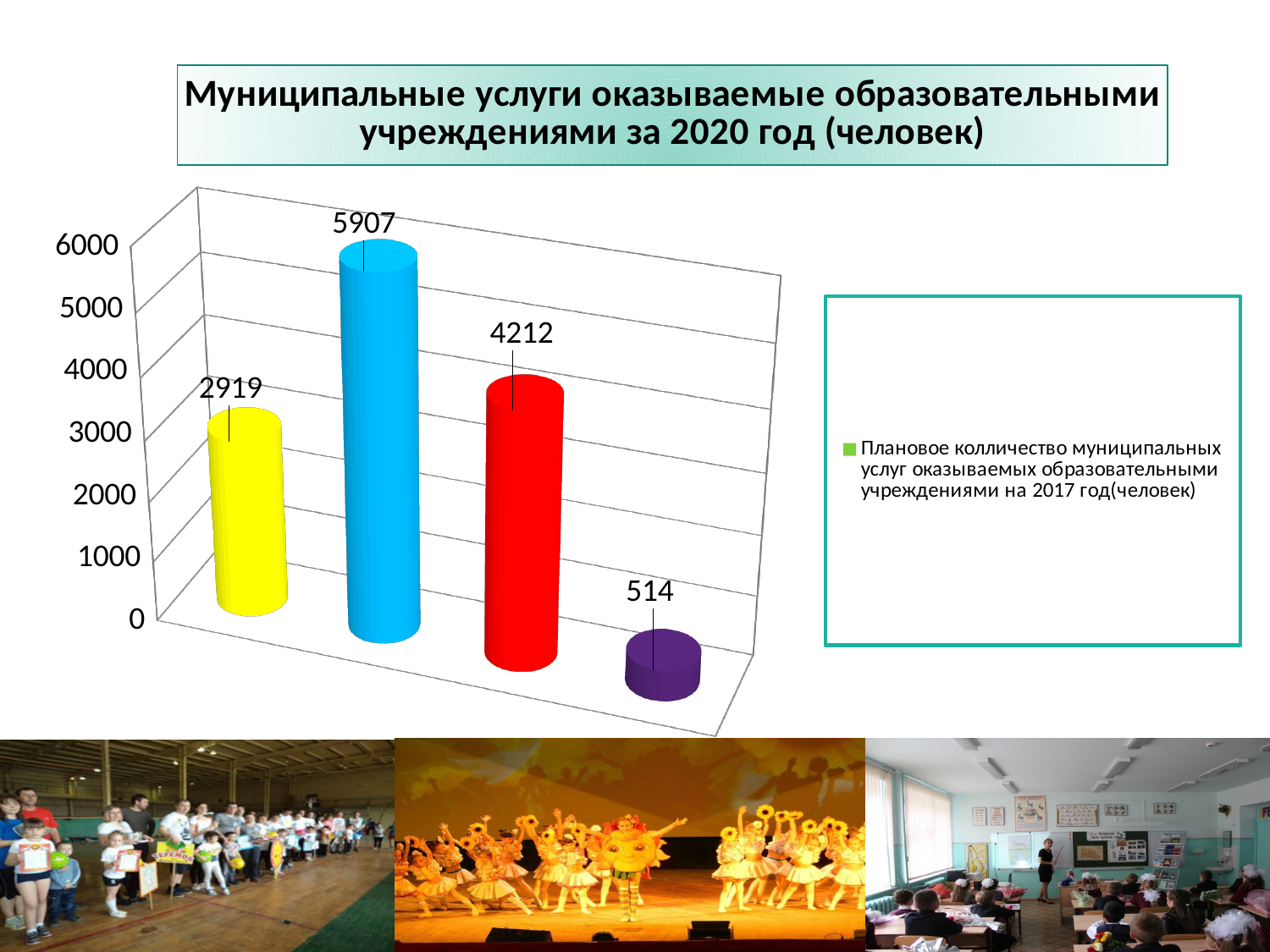
Which bar has the lowest value? The purple bar (514) What value is shown on the blue bar? 5907 What is the difference between the blue bar and the red bar? 1695 What value is shown on the yellow bar? 2919 What value is shown on the red bar? 4212 What is the difference between the yellow bar and the purple bar? 2405 Which bar has the highest value? The blue bar (5907) What kind of chart is shown on the slide? Bar chart Which is larger, the yellow bar or the red bar? The red bar How many bars are plotted in the chart? 4 What value is shown on the purple bar? 514 How many series does the legend list? 1